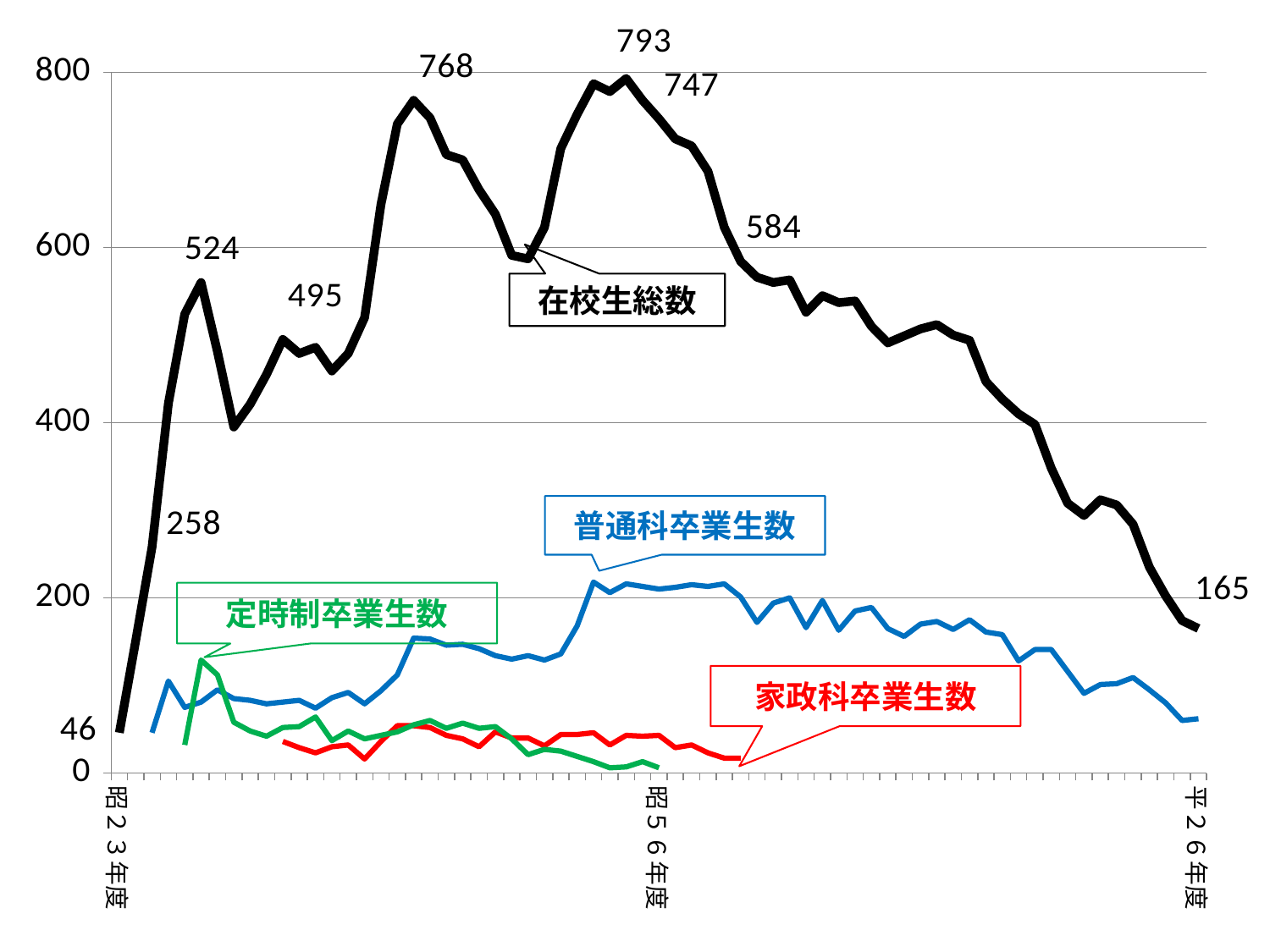
What is the difference between the peak value 793 and the final value 165 on the 在校生総数 line? 628 What colour is the 家政科卒業生数 line? red What is the highest labelled value on the 在校生総数 line? 793 How many data series are labelled on the chart? 4 What kind of chart is shown on the slide? line chart Which series is plotted highest on the chart across the whole period? 在校生総数 Does the 在校生総数 line rise or fall from 昭56年度 to 平26年度? fall Is the value of 普通科卒業生数 at 平26年度 greater or less than 200? less Which labelled peak on the 在校生総数 line is larger, 768 or 793? 793 What is the value of 在校生総数 at 平26年度? 165 What is the value of 在校生総数 at 昭23年度? 46 What is the difference between the labelled values 524 and 258 on the 在校生総数 line? 266